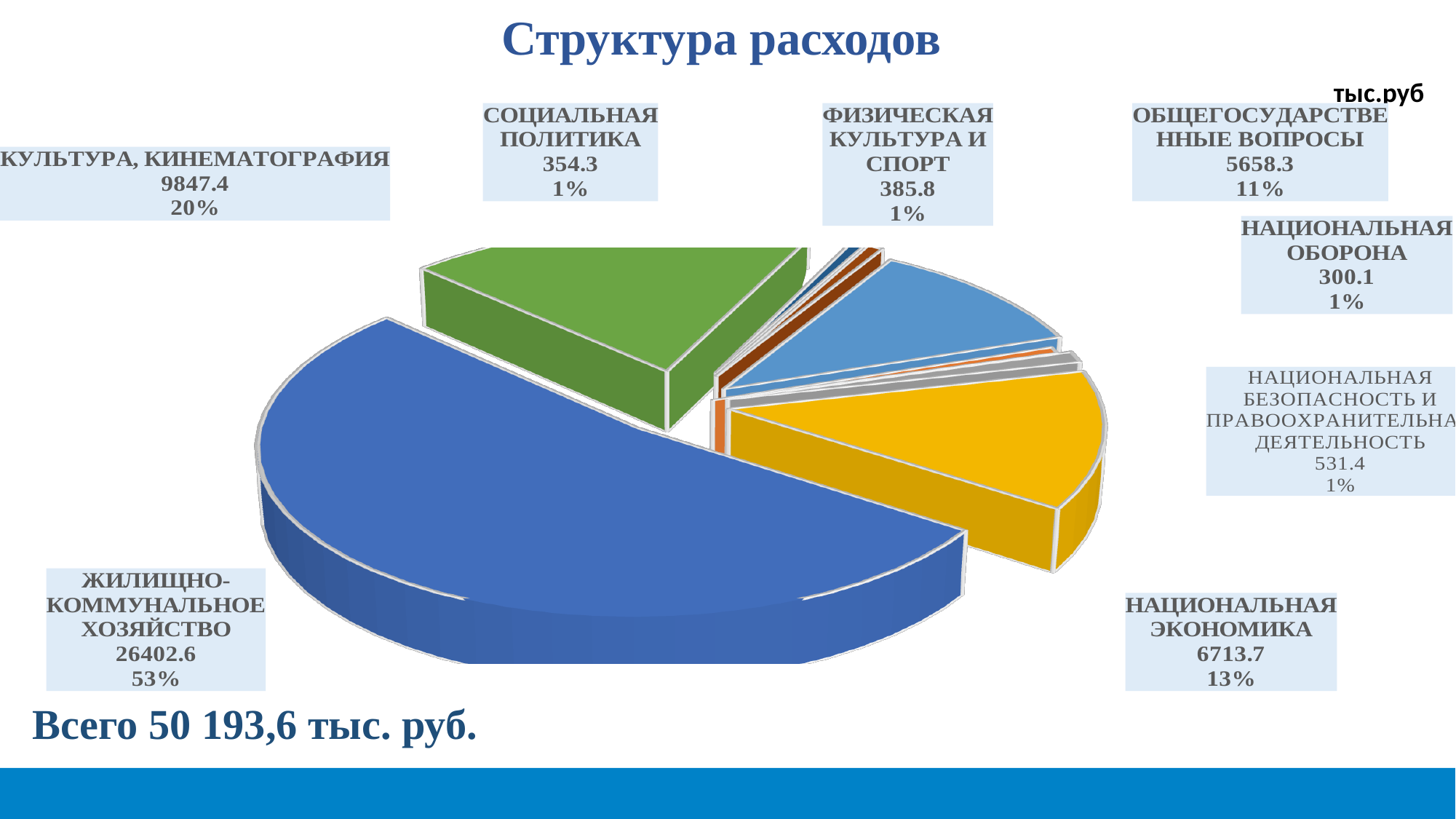
What is the value for ЖИЛИЩНО-КОММУНАЛЬНОЕ ХОЗЯЙСТВО? 26402.6 What is the difference between the values for КУЛЬТУРА, КИНЕМАТОГРАФИЯ and НАЦИОНАЛЬНАЯ ЭКОНОМИКА? 3133.7 Which category has the smallest value? НАЦИОНАЛЬНАЯ ОБОРОНА What is the title of the chart? Структура расходов What share of the pie does КУЛЬТУРА, КИНЕМАТОГРАФИЯ represent? 20% How many categories does the pie chart show? 8 What share of the pie does НАЦИОНАЛЬНАЯ ЭКОНОМИКА represent? 13% Which category has the largest value? ЖИЛИЩНО-КОММУНАЛЬНОЕ ХОЗЯЙСТВО What is the value for НАЦИОНАЛЬНАЯ ЭКОНОМИКА? 6713.7 Which is larger, the value for СОЦИАЛЬНАЯ ПОЛИТИКА or the value for ФИЗИЧЕСКАЯ КУЛЬТУРА И СПОРТ? ФИЗИЧЕСКАЯ КУЛЬТУРА И СПОРТ What kind of chart is shown on the slide? Pie chart What is the value for ОБЩЕГОСУДАРСТВЕННЫЕ ВОПРОСЫ? 5658.3